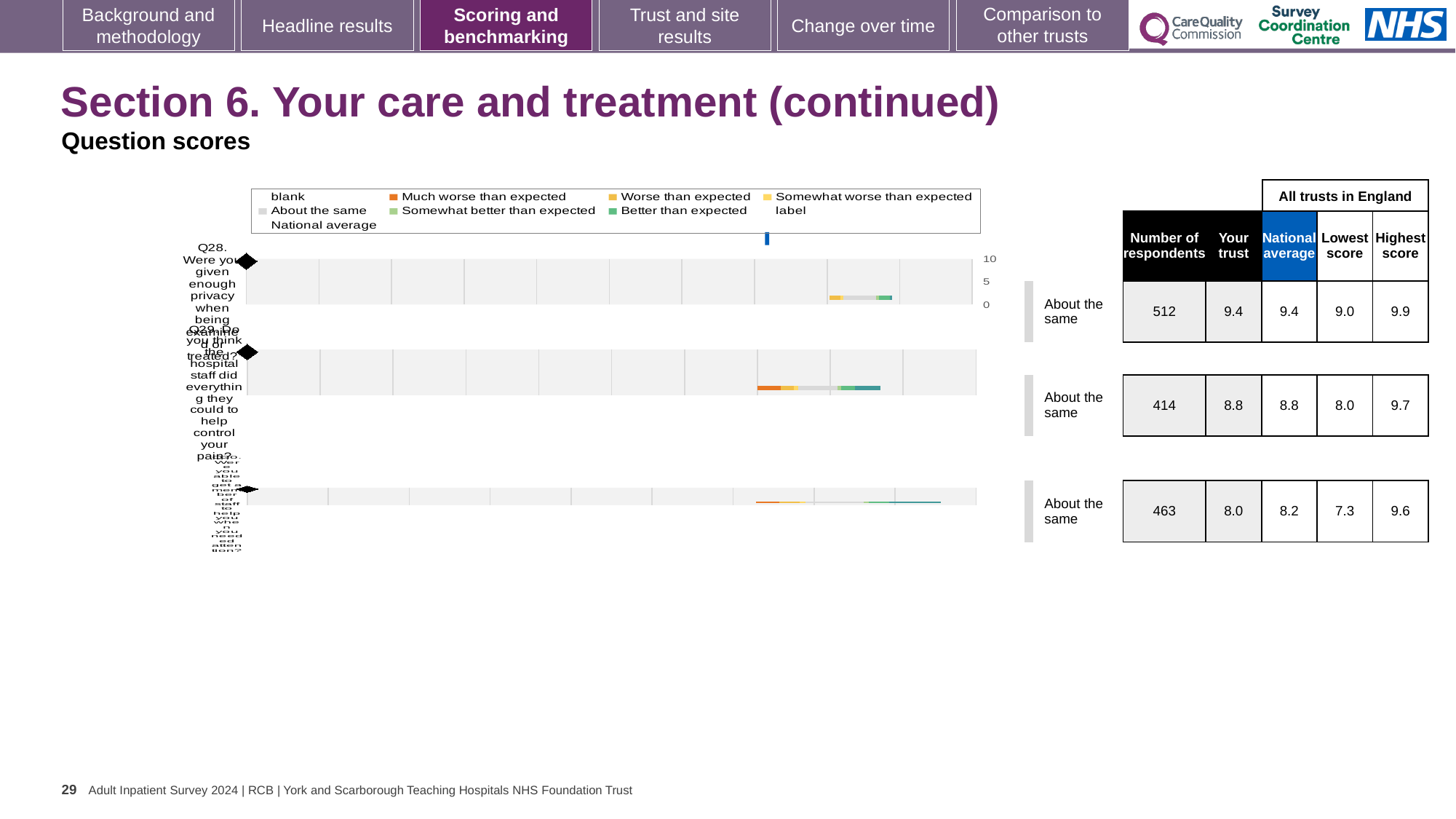
What is the highest score among all trusts in England for Q28? 9.9 How many questions (rows) are plotted in the chart? 3 How many entries does the chart legend list? 9 Which of the three questions has the largest number of respondents? Q28 What benchmark category is shown for Q28? About the same How many respondents answered Q29 (Do you think hospital staff did everything they could to help control your pain?)? 414 Which question has the higher 'Your trust' score, Q28 or Q29? Q28 What is the 'Your trust' score for Q28 (Were you given enough privacy when being examined or treated?)? 9.4 What kind of chart is used to show the question scores on this slide? bar chart What is the national average score for the bottom (third) question row? 8.2 What is the difference between the highest score and the lowest score for Q29? 1.7 What is the lowest score among all trusts in England for the bottom (third) question row? 7.3